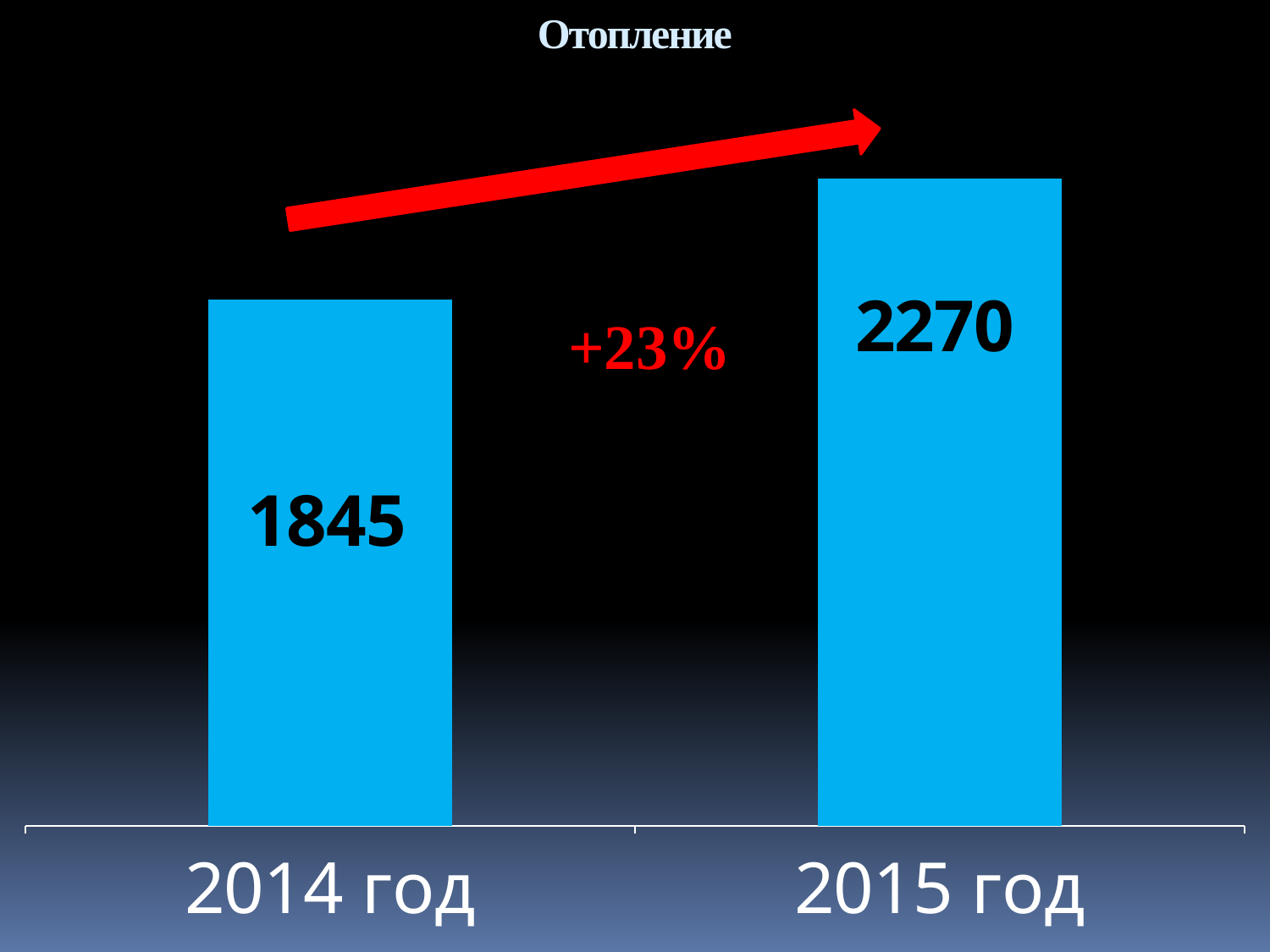
Which year has the lowest value? 2014 год What is the difference between the values for 2015 год and 2014 год? 425 What is the value for 2015 год? 2270 How many categories are shown in the chart? 2 What is the title of the chart? Отопление What kind of chart is shown on the slide? bar chart What percentage change is printed in red between the two bars? +23% Do the values rise or fall from 2014 год to 2015 год? rise Which year has the highest value? 2015 год Which is larger, the value for 2014 год or the value for 2015 год? 2015 год What is the value for 2014 год? 1845